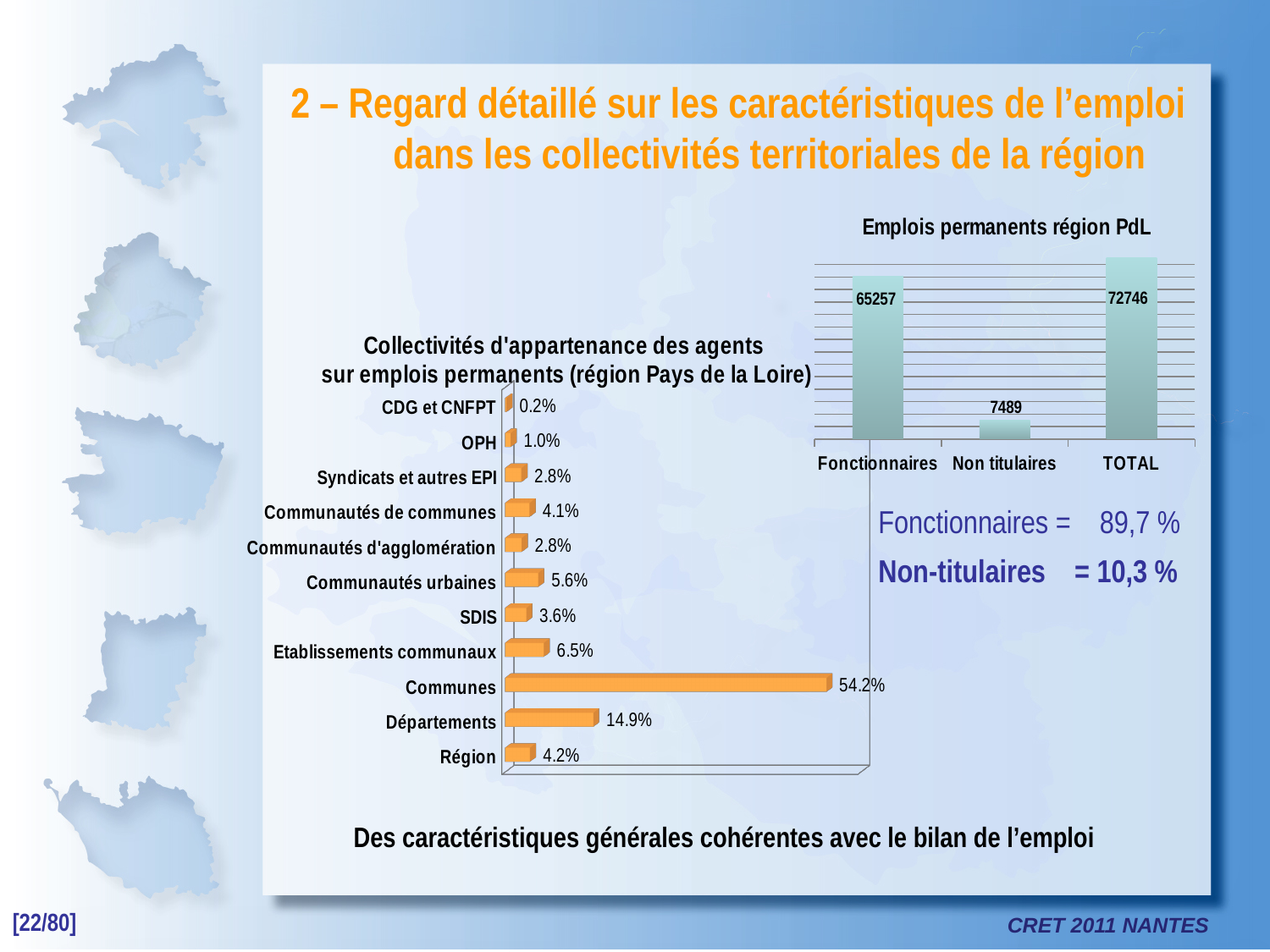
In the chart 'Collectivités d'appartenance des agents sur emplois permanents (région Pays de la Loire)', which category has the highest value? Communes In the chart 'Emplois permanents région PdL', what is the value for Fonctionnaires? 65257 How many categories are shown in the chart 'Emplois permanents région PdL'? 3 In the chart 'Collectivités d'appartenance des agents sur emplois permanents (région Pays de la Loire)', what is the value for Départements? 14.9% What kind of chart is 'Collectivités d'appartenance des agents sur emplois permanents (région Pays de la Loire)'? Bar chart In the chart 'Emplois permanents région PdL', what is the difference between TOTAL and Fonctionnaires? 7489 How many categories are shown in the chart 'Collectivités d'appartenance des agents sur emplois permanents (région Pays de la Loire)'? 11 In the chart 'Collectivités d'appartenance des agents sur emplois permanents (région Pays de la Loire)', what is the difference between Etablissements communaux and SDIS? 2.9% In the chart 'Collectivités d'appartenance des agents sur emplois permanents (région Pays de la Loire)', what is the value for Communes? 54.2% In the chart 'Collectivités d'appartenance des agents sur emplois permanents (région Pays de la Loire)', which category has the lowest value? CDG et CNFPT In the chart 'Collectivités d'appartenance des agents sur emplois permanents (région Pays de la Loire)', which is larger: Communautés urbaines or Communautés de communes? Communautés urbaines In the chart 'Emplois permanents région PdL', what is the value for Non titulaires? 7489